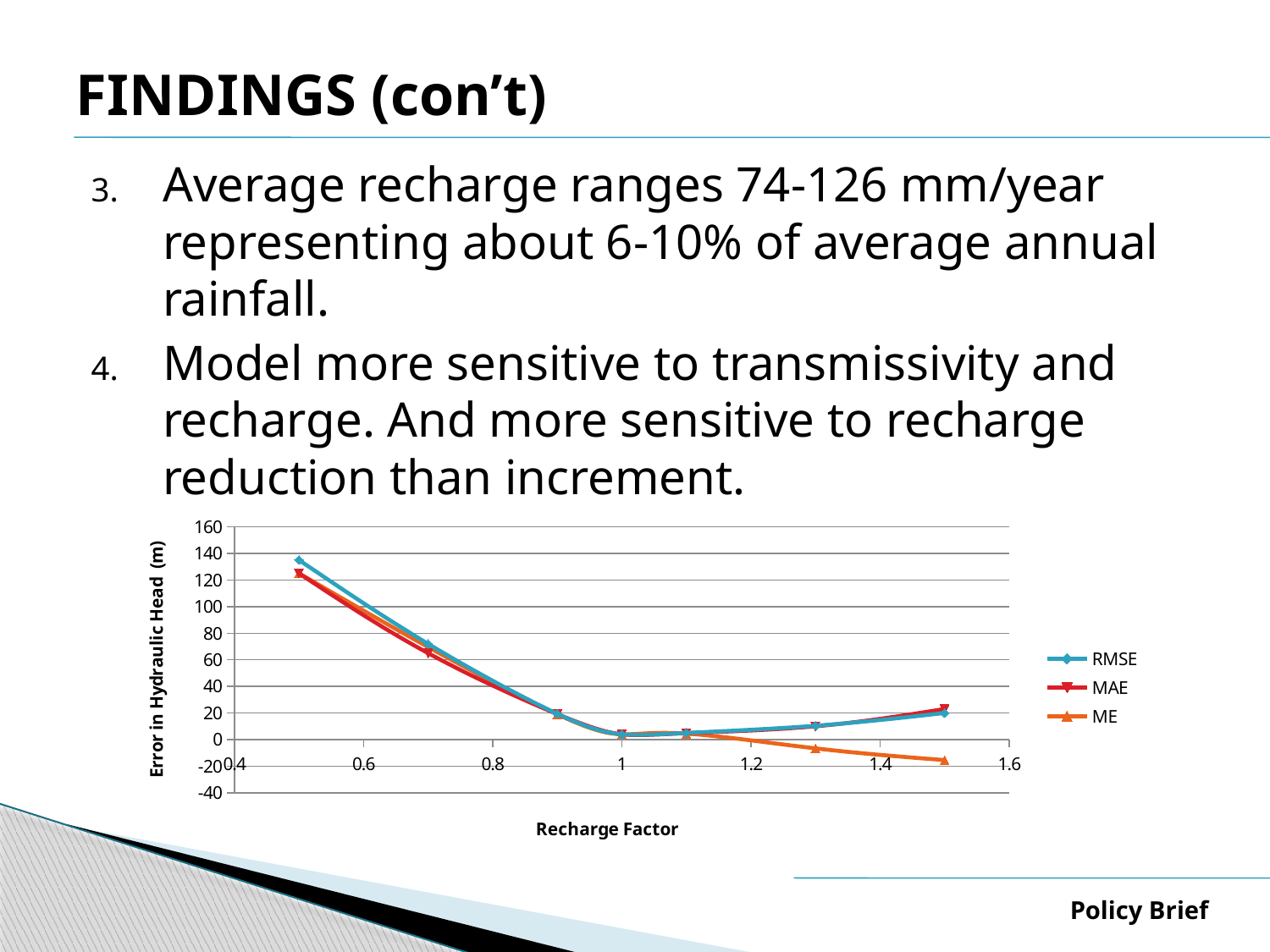
Is the ME value at recharge factor 1.5 greater or less than 0? less What is the title of the chart's x axis? Recharge Factor What kind of chart is shown on the slide? line chart How many series does the chart legend list? 3 Does the ME series rise or fall as the recharge factor increases from 1.1 to 1.5? fall Does the RMSE series rise or fall as the recharge factor increases from 0.5 to 1? fall Is the RMSE value at recharge factor 1.5 greater or less than 40? less What are the series names listed in the chart legend? RMSE, MAE, ME At recharge factor 1.5, which is larger, the RMSE value or the ME value? RMSE Is the RMSE value at recharge factor 0.5 greater or less than 120? greater Which series has the highest value at recharge factor 0.5? RMSE Which series has the lowest value at recharge factor 1.5? ME